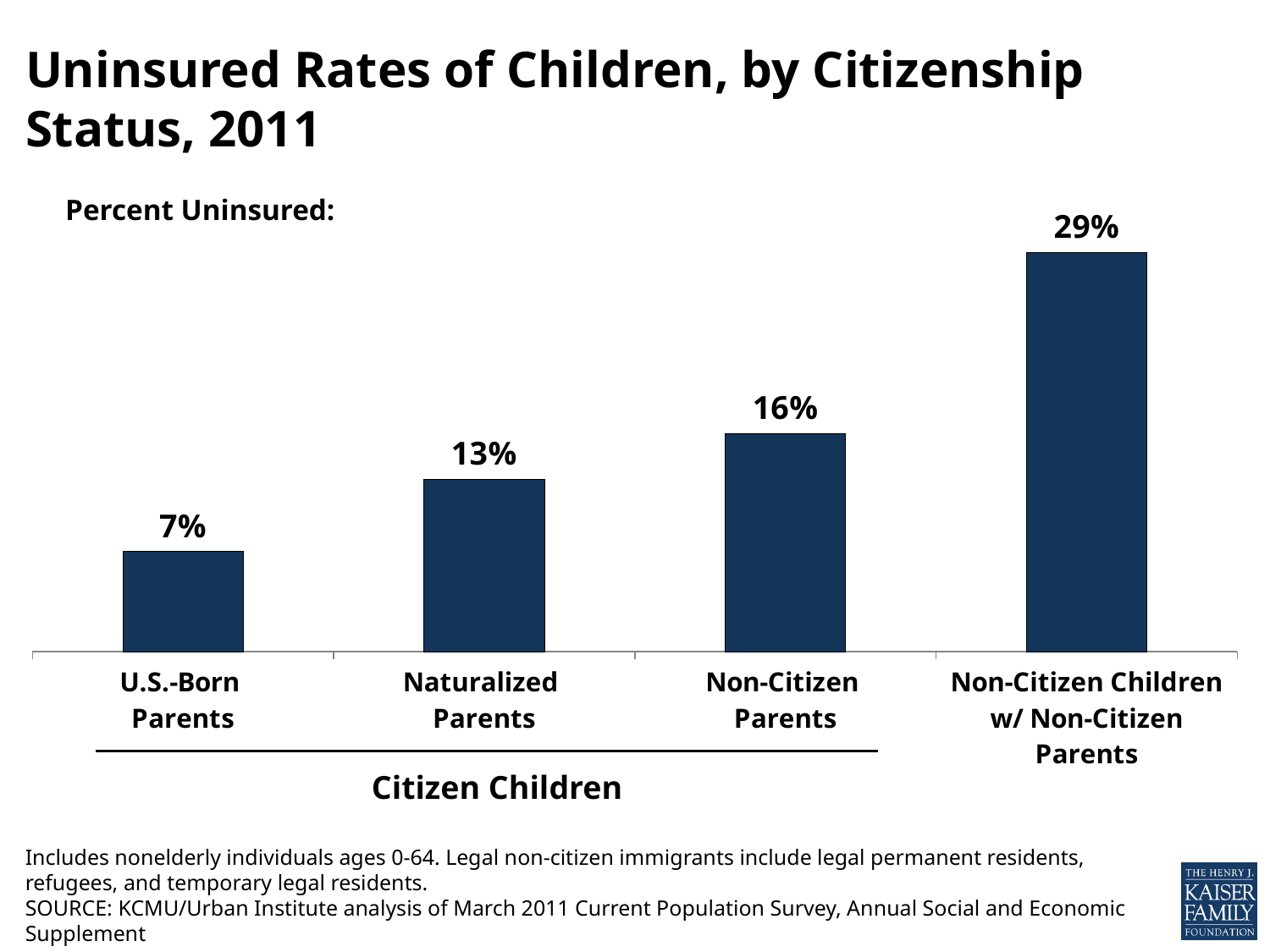
Do the uninsured rates rise or fall moving from left to right across the categories? Rise What is the uninsured rate for citizen children with U.S.-born parents? 7% What is the uninsured rate for non-citizen children with non-citizen parents? 29% What is the difference in uninsured rate between non-citizen children with non-citizen parents and citizen children with U.S.-born parents? 22 percentage points Which has a higher uninsured rate: citizen children with naturalized parents or citizen children with non-citizen parents? Non-Citizen Parents What type of chart is shown on the slide? Bar chart What is the uninsured rate for citizen children with naturalized parents? 13% What is the uninsured rate for citizen children with non-citizen parents? 16% Which category has the lowest uninsured rate? U.S.-Born Parents How many categories are shown in the chart? 4 Which category has the highest uninsured rate? Non-Citizen Children w/ Non-Citizen Parents What is the difference in uninsured rate between citizen children with non-citizen parents and citizen children with naturalized parents? 3 percentage points